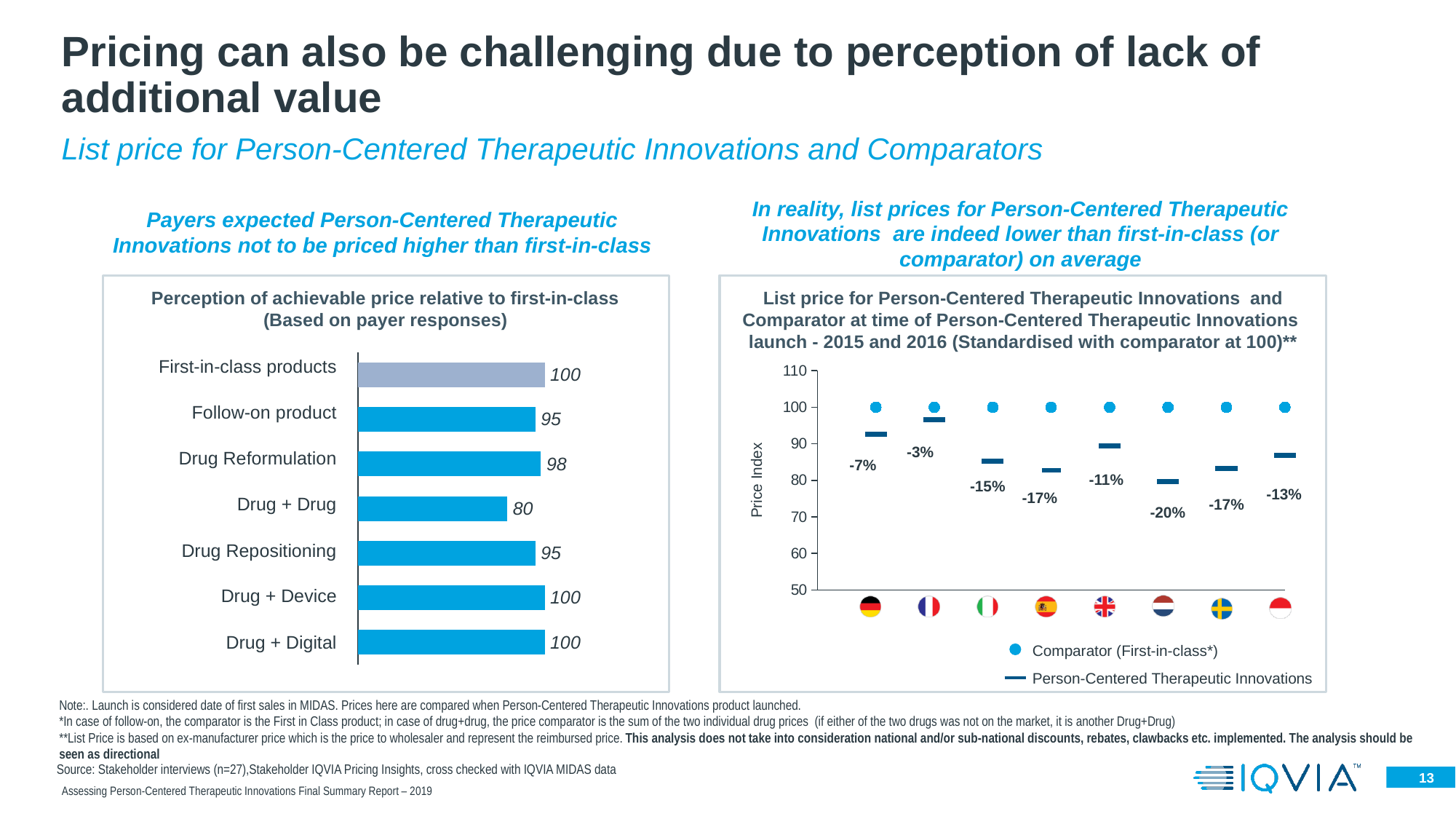
In the left chart (Perception of achievable price relative to first-in-class), what is the value for Drug + Drug? 80 In the left chart (Perception of achievable price relative to first-in-class), what is the difference between the values for First-in-class products and Drug + Drug? 20 In the right chart (List price for Person-Centered Therapeutic Innovations and Comparator), what is the label of the y axis? Price Index In the left chart (Perception of achievable price relative to first-in-class), which is larger: the value for Drug Reformulation or the value for Follow-on product? Drug Reformulation In the left chart (Perception of achievable price relative to first-in-class), what is the value for Drug Reformulation? 98 In the right chart (List price for Person-Centered Therapeutic Innovations and Comparator), how many countries (data points per series) are plotted? 8 In the right chart (List price for Person-Centered Therapeutic Innovations and Comparator), how many series does the legend list? 2 What kind of chart is the left chart (Perception of achievable price relative to first-in-class)? Bar chart In the right chart (List price for Person-Centered Therapeutic Innovations and Comparator), what is the largest percentage reduction labelled on the chart? -20% In the left chart (Perception of achievable price relative to first-in-class), how many categories are shown? 7 In the left chart (Perception of achievable price relative to first-in-class), which category has the lowest value? Drug + Drug In the left chart (Perception of achievable price relative to first-in-class), what is the value for Drug Repositioning? 95